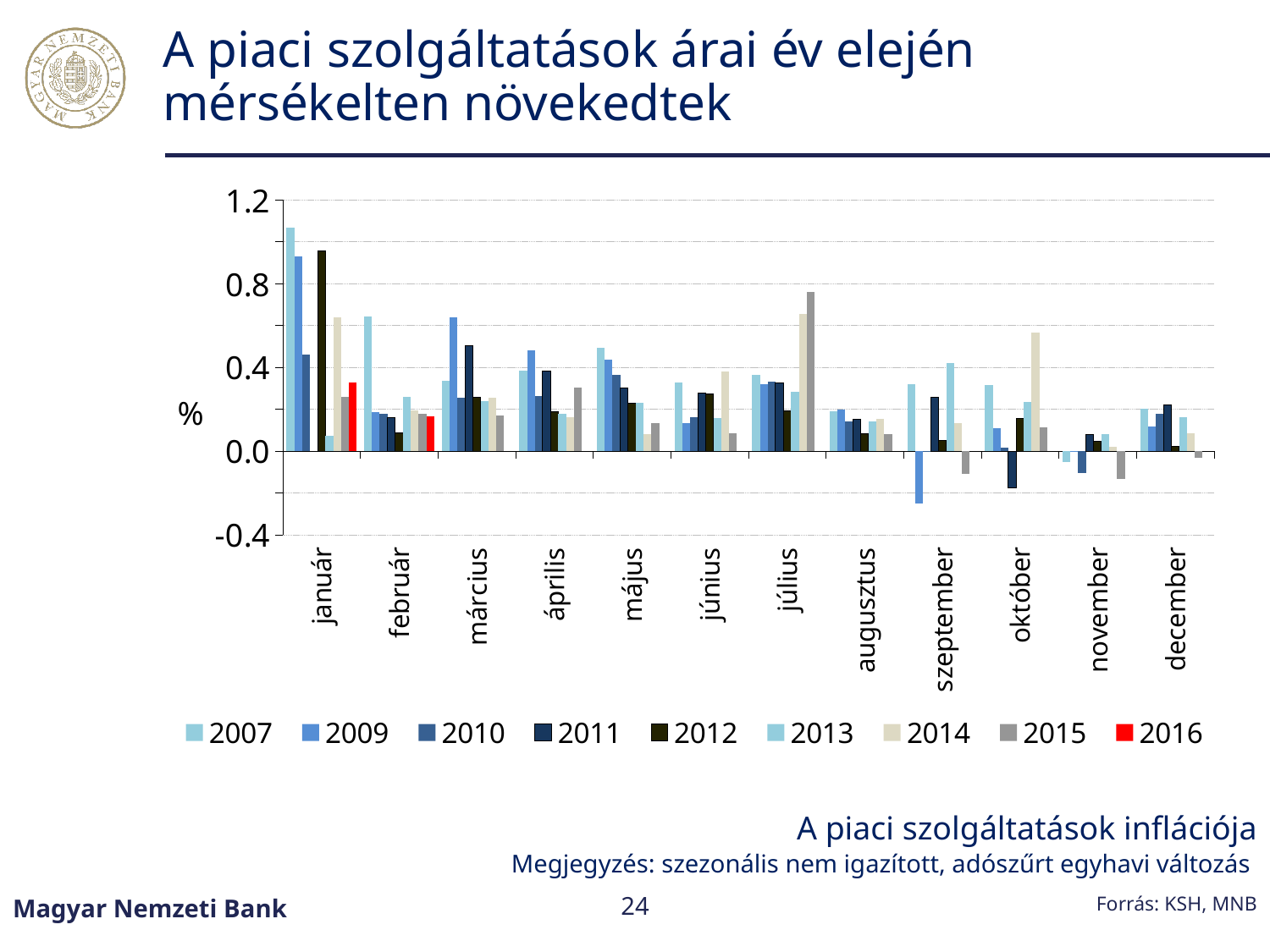
Which series has the lowest value in szeptember? 2009 Is the value for 2009 in szeptember greater or less than 0.0? less What kind of chart is shown on the slide? bar chart How many months (categories) are shown on the x axis? 12 Is the value for 2015 in július greater or less than 0.4? greater Is the value for 2011 in október greater or less than 0.0? less Which series is shown in red in the legend? 2016 In which month does the 2007 series reach its highest value? január In január, which is larger: the value for 2007 or the value for 2016? 2007 How many series does the legend list? 9